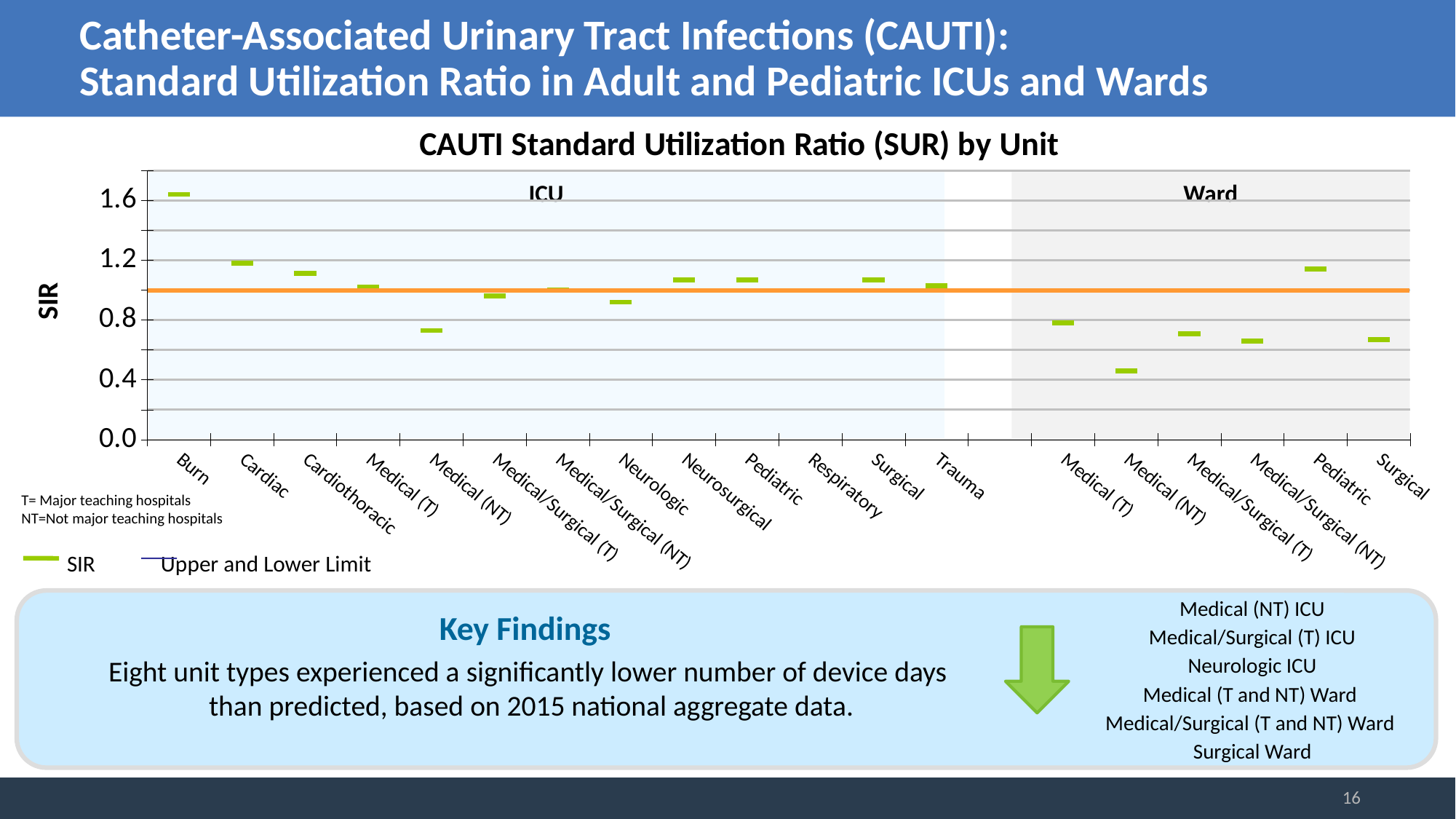
Which unit has the lowest SIR value in the chart? Medical (NT) Ward Which has a higher SIR value, the Cardiac ICU or the Neurologic ICU? Cardiac ICU Which has a higher SIR value, the Pediatric Ward or the Surgical Ward? Pediatric Ward Is the SIR value for the Pediatric Ward greater or less than 1.2? less How many entries does the chart legend list? 2 Is the SIR value for the Burn ICU greater or less than 1.6? greater How many unit categories are listed on the x axis of the chart? 19 Is the SIR value for the Medical (NT) ICU greater or less than 0.8? less Which unit has the highest SIR value in the chart? Burn What is the title of the chart? CAUTI Standard Utilization Ratio (SUR) by Unit